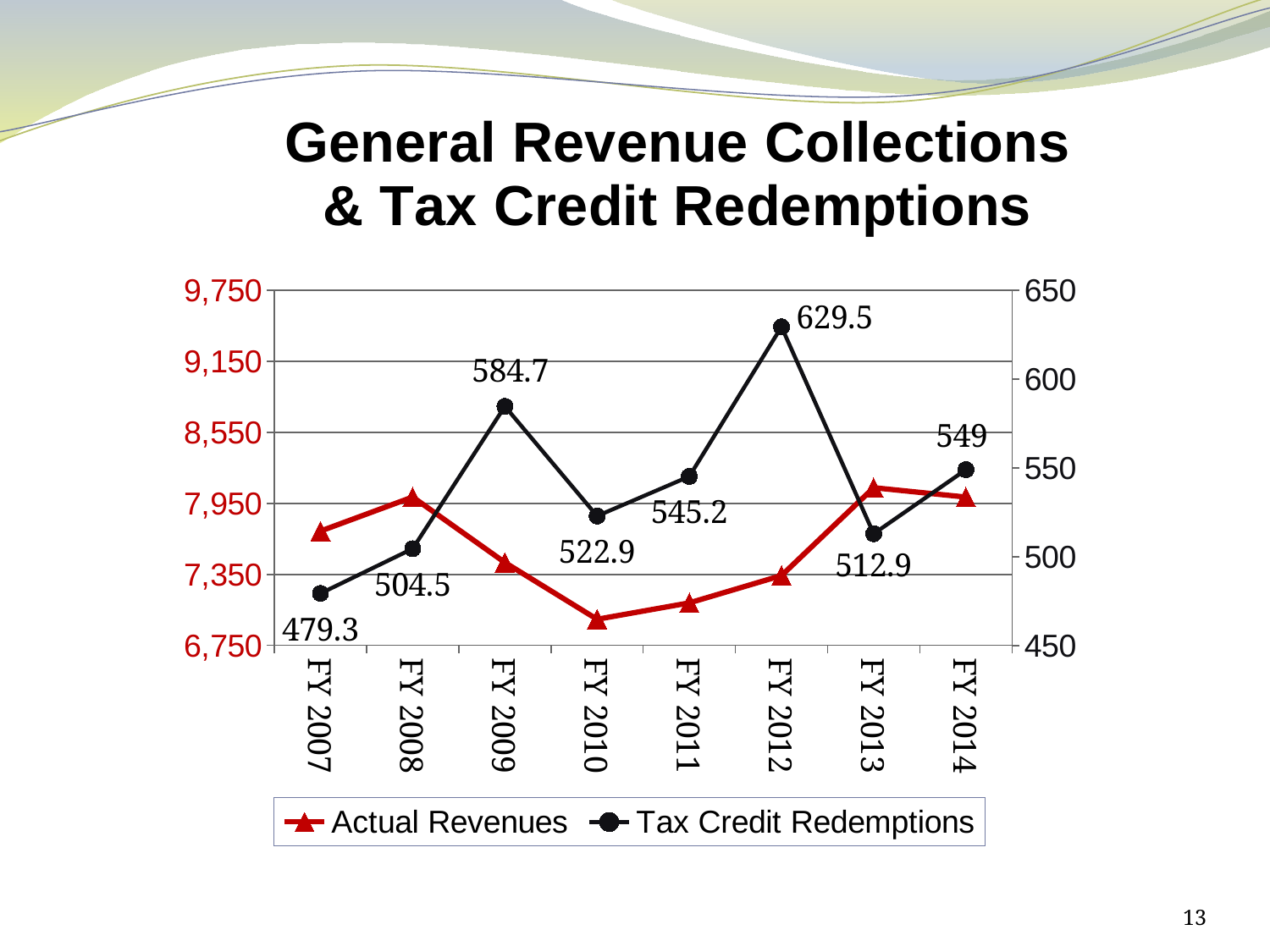
Is the Actual Revenues value for FY 2010 greater or less than 7,350? less How many series does the legend list? 2 In which fiscal year are Tax Credit Redemptions highest? FY 2012 What kind of chart is shown on the slide? line chart What is the Tax Credit Redemptions value for FY 2012? 629.5 Which is larger, the Tax Credit Redemptions value for FY 2011 or for FY 2010? FY 2011 What is the Tax Credit Redemptions value for FY 2007? 479.3 What is the Tax Credit Redemptions value for FY 2014? 549 How many fiscal years are shown on the x axis? 8 What is the difference between the Tax Credit Redemptions values for FY 2012 and FY 2007? 150.2 In which fiscal year are Tax Credit Redemptions lowest? FY 2007 Is the Actual Revenues value for FY 2009 greater or less than 7,350? greater